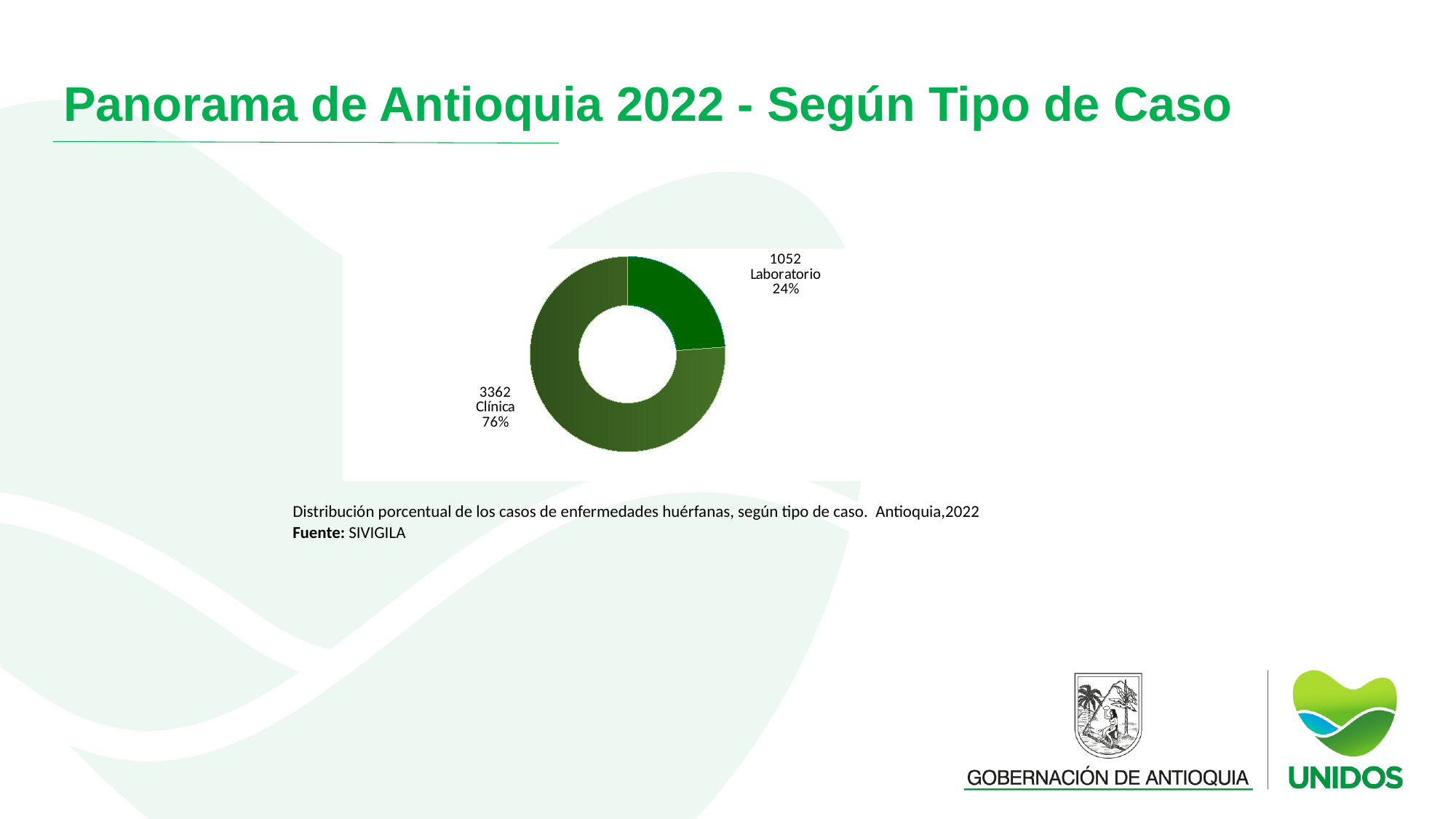
Which type of case has the highest number of cases? Clínica How many cases are labelled for Clínica? 3362 What kind of chart is shown on the slide? Doughnut chart How many categories (types of case) does the chart show? 2 What source is cited for the chart data? SIVIGILA What percentage share does the Laboratorio slice have? 24% What is the difference in cases between Clínica and Laboratorio? 2310 Which has more cases, Clínica or Laboratorio? Clínica Which type of case has the lowest number of cases? Laboratorio What is the total number of cases across both slices? 4414 What percentage share does the Clínica slice have? 76% How many cases are labelled for Laboratorio? 1052